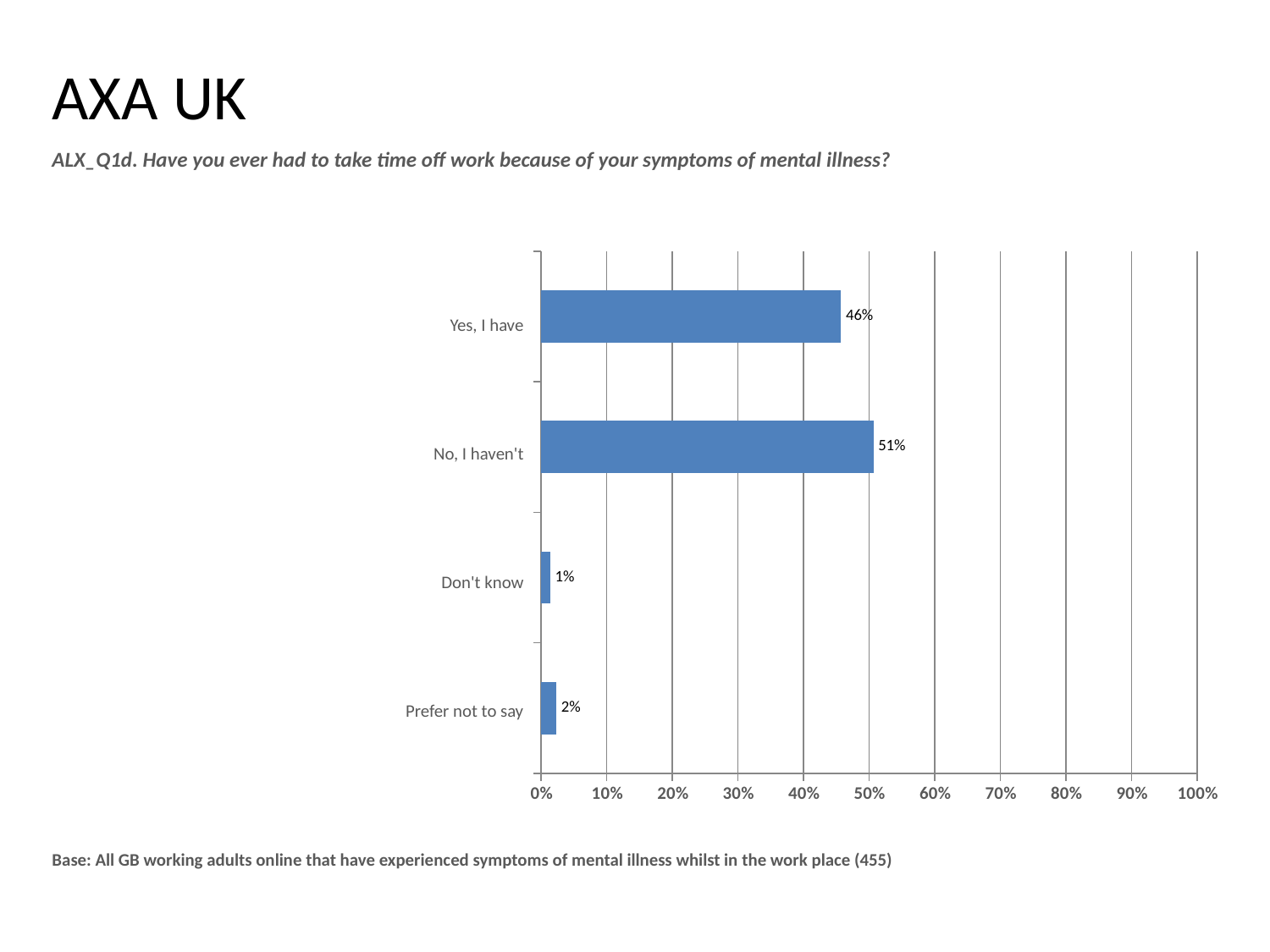
Is the value for "Yes, I have" greater or less than 50%? less What percentage of respondents answered "Yes, I have"? 46% Which response category has the highest percentage? No, I haven't How many response categories are shown in the chart? 4 Which response category has the lowest percentage? Don't know What percentage of respondents answered "Prefer not to say"? 2% What is the maximum value shown on the horizontal axis? 100% What percentage of respondents answered "Don't know"? 1% What kind of chart is shown on the slide? Bar chart Which is larger, the value for "Yes, I have" or the value for "No, I haven't"? No, I haven't What is the difference in percentage points between "No, I haven't" and "Yes, I have"? 5% What percentage of respondents answered "No, I haven't"? 51%